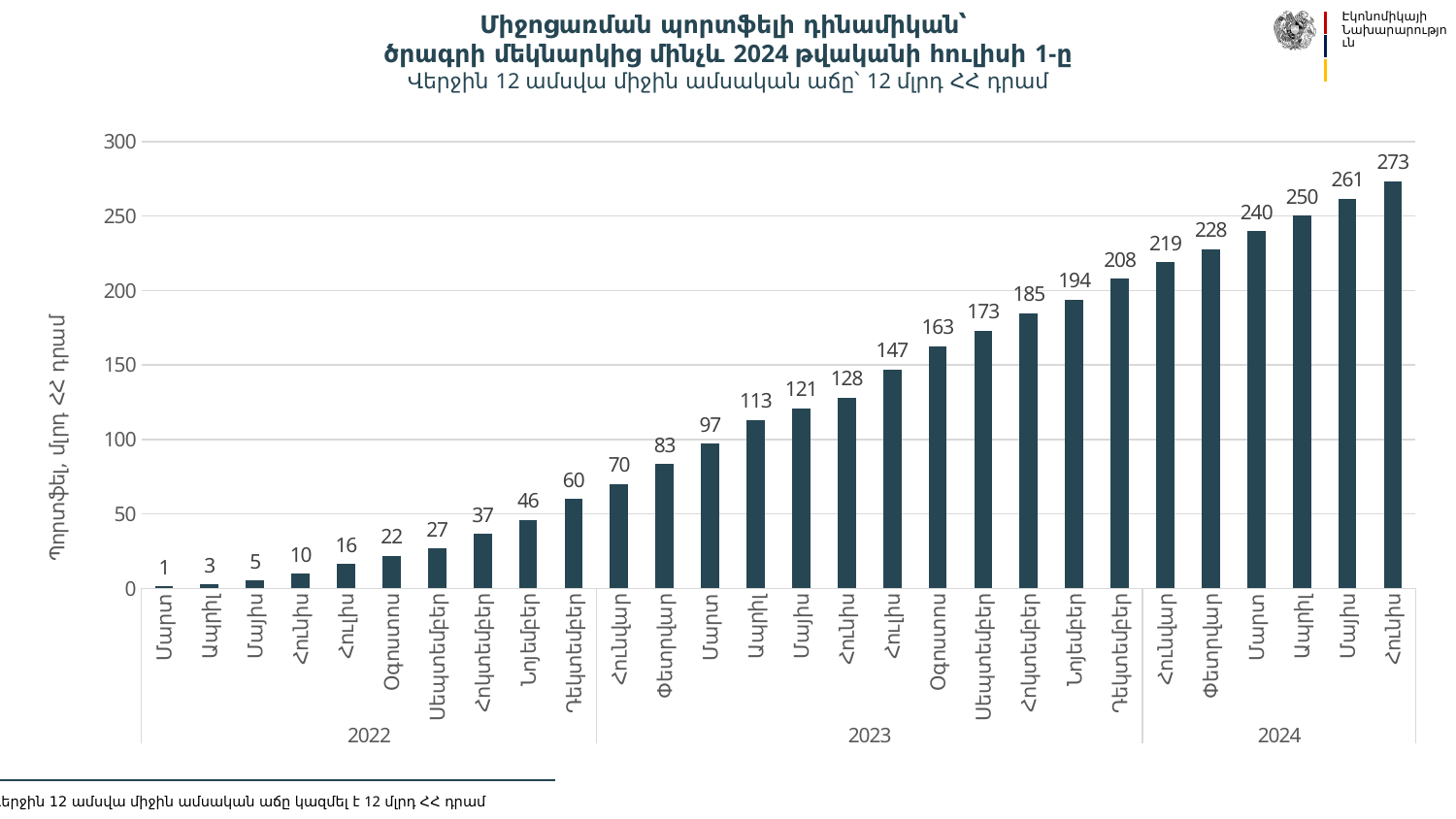
Which month has the highest value on the chart? June 2024 (Հունիս 2024) Which is larger, the value for January 2024 (Հունվար 2024) or the value for January 2023 (Հունվար 2023)? January 2024 How many bars (months) are plotted on the chart? 28 What is the value for July 2023 (Հուլիս, 2023)? 147 What is the maximum value shown on the vertical axis? 300 What kind of chart is shown on the slide? bar chart What is the value for December 2022 (Դեկտեմբեր, 2022)? 60 Is the value for April 2024 (Ապրիլ, 2024) greater or less than 200? greater Which month has the lowest value on the chart? March 2022 (Մարտ 2022) What is the difference between the values for December 2023 (208) and December 2022 (60)? 148 What is the value for June 2024 (Հունիս, 2024), the last bar on the chart? 273 Do the values rise or fall from left to right along the x axis? rise